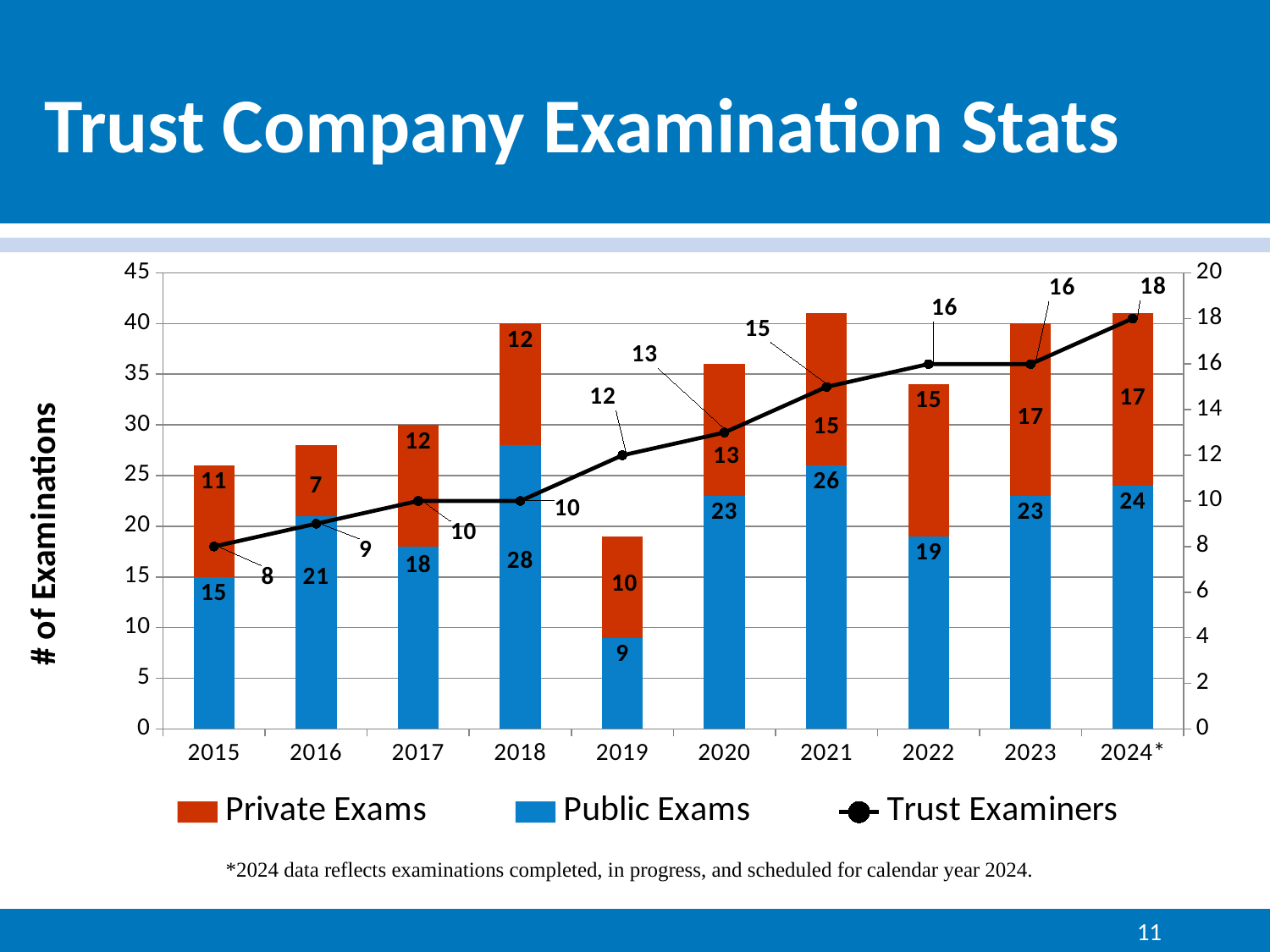
What is the value of Private Exams for 2016? 7 Which year has the lowest number of Trust Examiners? 2015 How many years are shown on the x axis? 10 Which year has the highest number of Public Exams? 2018 What is the total number of examinations (Private plus Public) for 2020? 36 How many series does the legend list? 3 What is the value of Public Exams for 2018? 28 How many Trust Examiners are shown for 2021? 15 Does the Trust Examiners line generally rise or fall from 2015 to 2024*? rise Which year has the lowest number of Public Exams? 2019 Which is larger in 2019, Private Exams or Public Exams? Private Exams What is the difference between Public Exams and Private Exams in 2021? 11